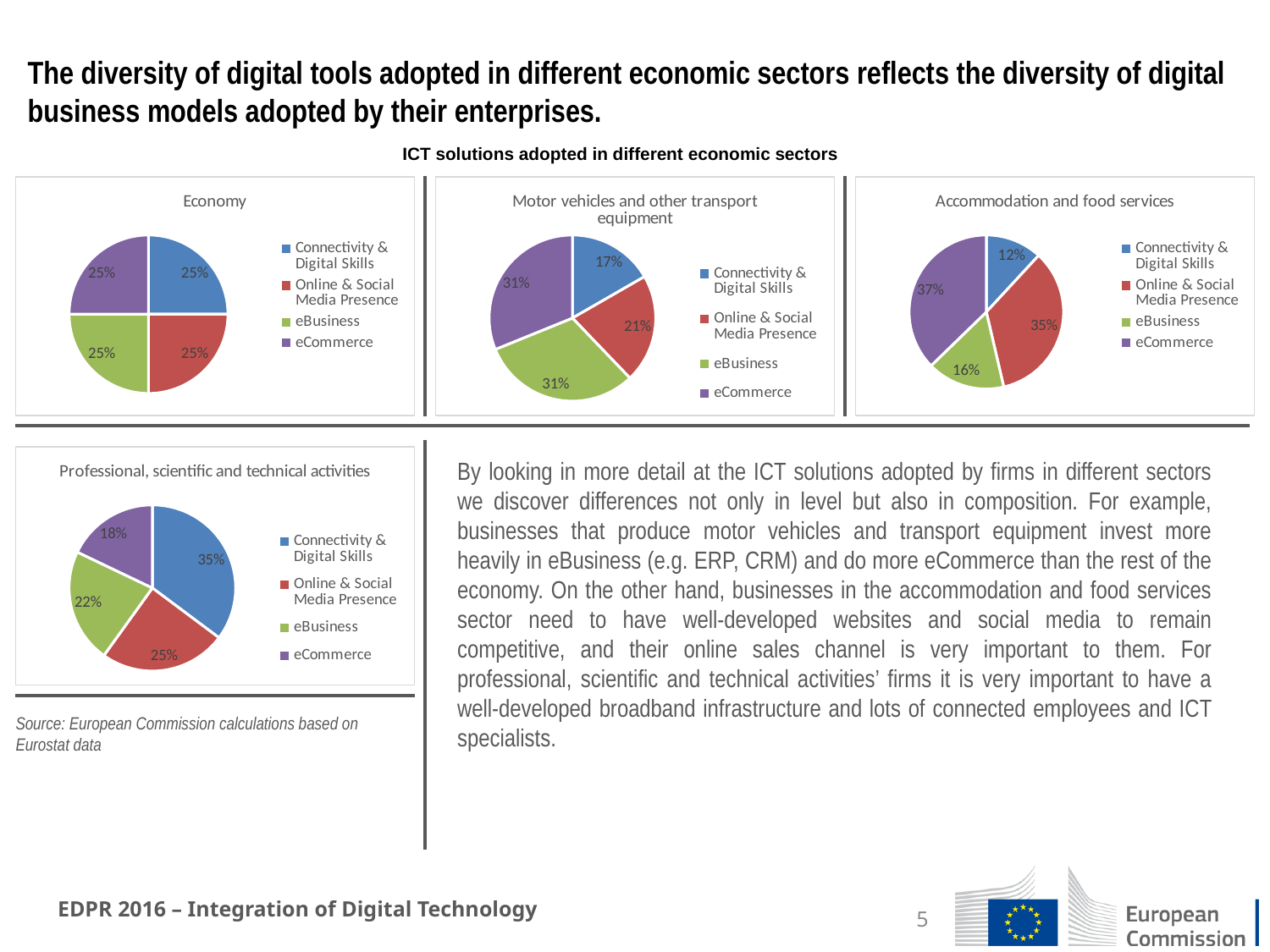
In the 'Accommodation and food services' chart, what share is eCommerce? 37% What type of chart is used for 'Motor vehicles and other transport equipment'? Pie chart In the 'Professional, scientific and technical activities' chart, which category has the largest share? Connectivity & Digital Skills How many categories does the 'Economy' pie chart show? 4 In the 'Accommodation and food services' chart, which category has the smallest share? Connectivity & Digital Skills In the 'Economy' chart, what share is Online & Social Media Presence? 25% In the 'Motor vehicles and other transport equipment' chart, which category has the smallest share? Connectivity & Digital Skills In the 'Professional, scientific and technical activities' chart, which is larger: Online & Social Media Presence or eCommerce? Online & Social Media Presence In the 'Professional, scientific and technical activities' chart, what share is eBusiness? 22% In the 'Motor vehicles and other transport equipment' chart, what share is Connectivity & Digital Skills? 17% In the 'Accommodation and food services' chart, what is the difference between the eCommerce share and the Connectivity & Digital Skills share? 25 percentage points In the 'Economy' chart, which colour represents eBusiness? Green